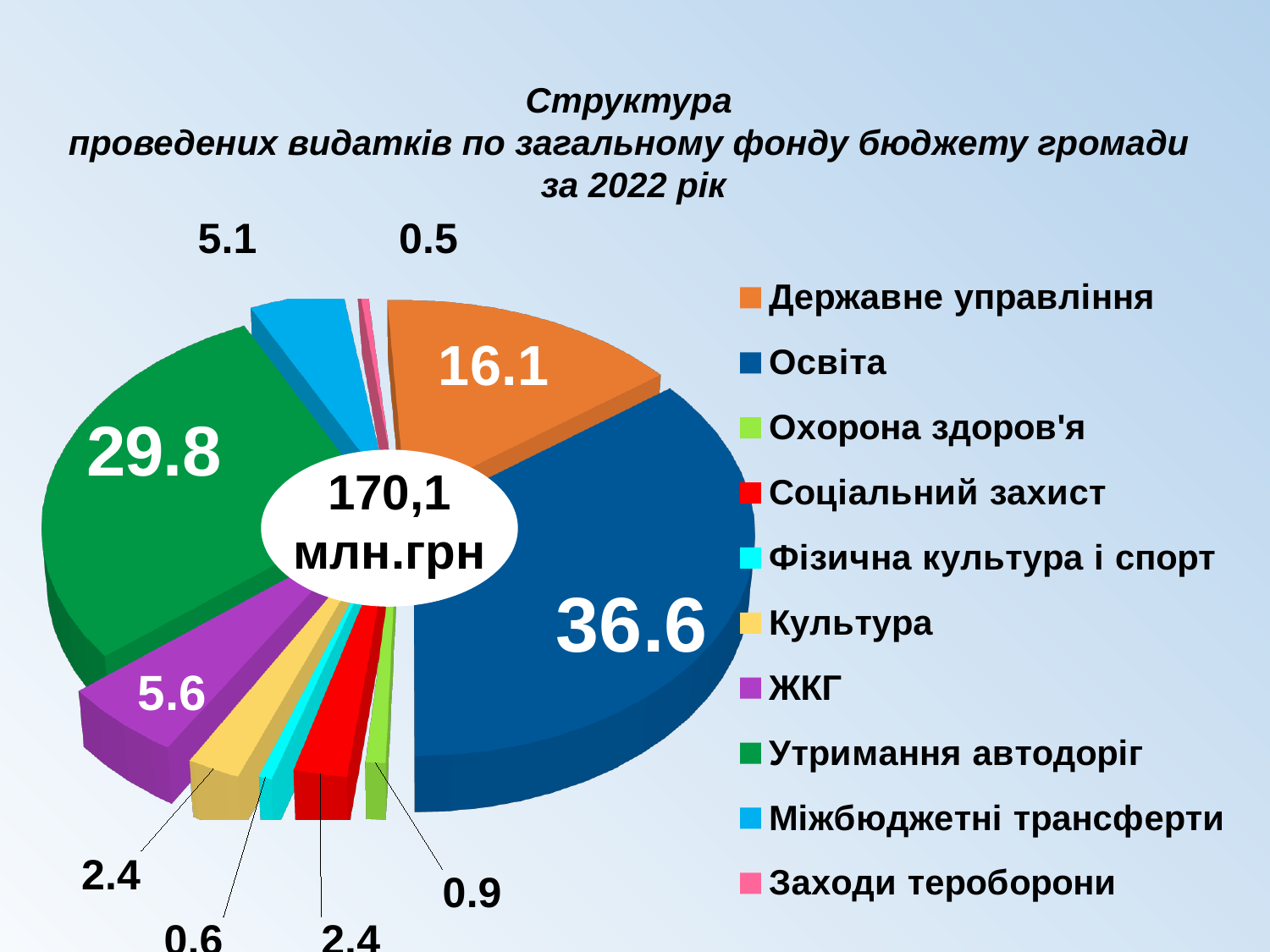
What is the value shown for ЖКГ? 5.6 How many categories does the legend list? 10 What type of chart is shown on the slide? Pie chart Which is larger, the value for Державне управління or the value for ЖКГ? Державне управління What is the value shown for Міжбюджетні трансферти? 5.1 What is the value shown for Державне управління? 16.1 What is the value shown for Освіта? 36.6 What is the value shown for Утримання автодоріг? 29.8 What is the difference between the values for Освіта and Утримання автодоріг? 6.8 What total amount is written in the centre of the pie chart? 170,1 млн.грн Which category has the smallest slice of the pie? Заходи тероборони Which category has the largest slice of the pie? Освіта